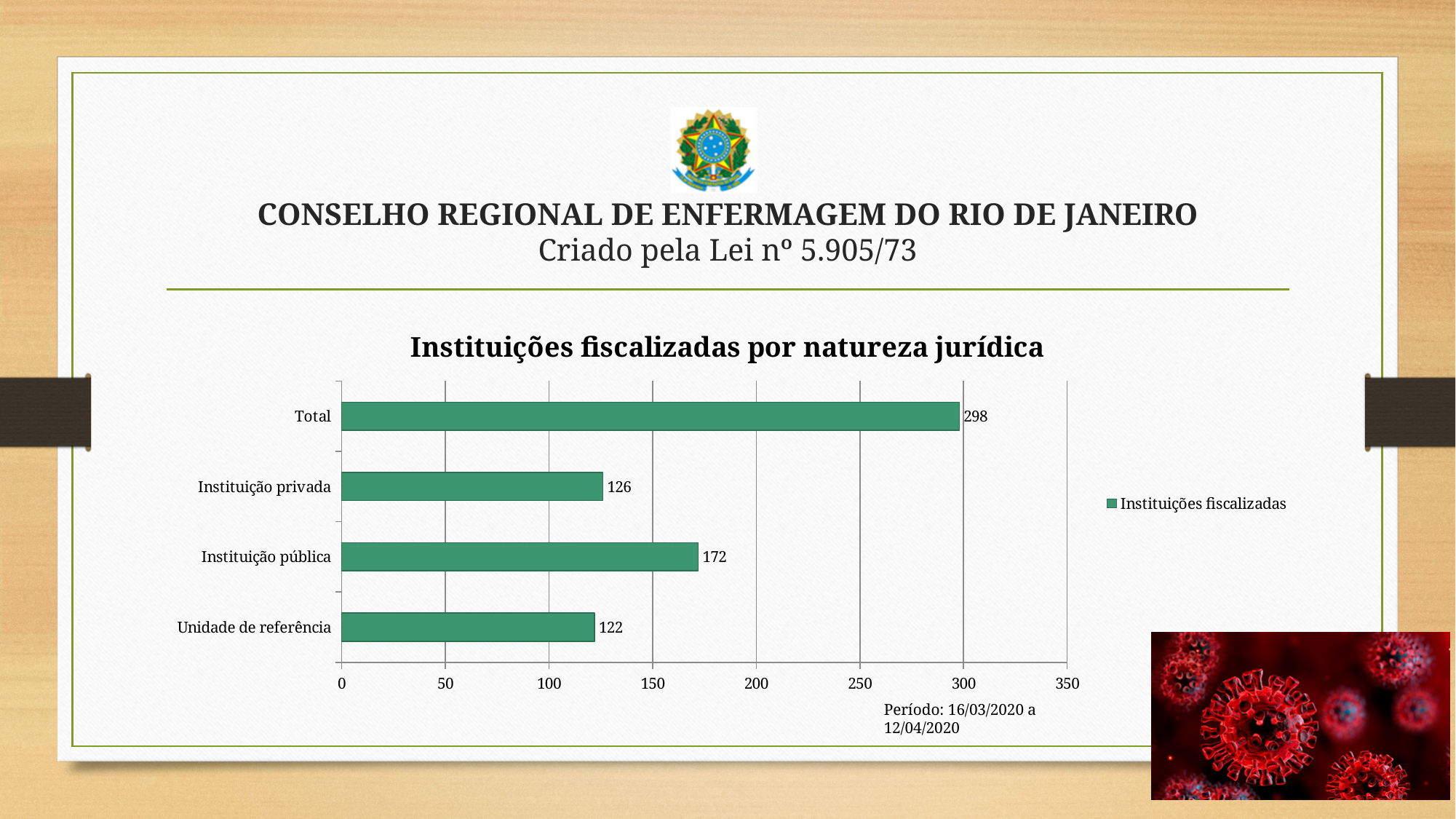
What is the value for Instituição privada? 126 Excluding the Total bar, which category has the highest value? Instituição pública What is the title of the chart? Instituições fiscalizadas por natureza jurídica Which is larger, the value for Instituição privada or the value for Unidade de referência? Instituição privada What is the value for Unidade de referência? 122 Is the value for Instituição pública greater or less than 150? greater What type of chart is shown on the slide? Bar chart What is the value for Instituição pública? 172 Which category has the lowest value? Unidade de referência How many bars are shown in the chart? 4 What is the difference between the values for Instituição pública and Instituição privada? 46 What is the value for Total? 298